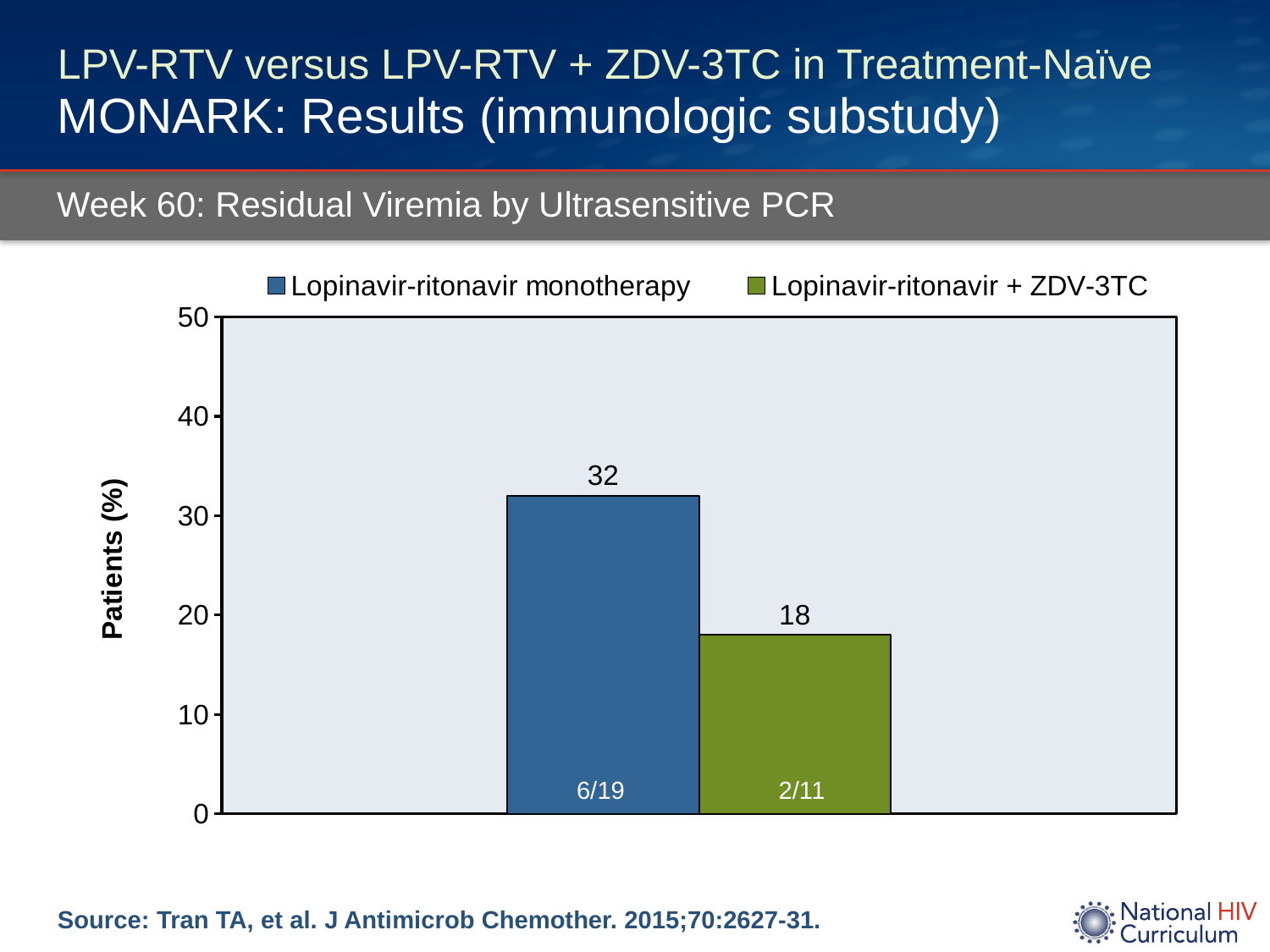
What fraction is printed inside the Lopinavir-ritonavir monotherapy bar? 6/19 What is the label of the y axis? Patients (%) Which series has the higher value? Lopinavir-ritonavir monotherapy Is the value for Lopinavir-ritonavir monotherapy larger or smaller than the value for Lopinavir-ritonavir + ZDV-3TC? larger What is the difference between the Lopinavir-ritonavir monotherapy value and the Lopinavir-ritonavir + ZDV-3TC value? 14 Which series has the lower value? Lopinavir-ritonavir + ZDV-3TC Is the value for Lopinavir-ritonavir monotherapy greater or less than 30? greater What is the value for Lopinavir-ritonavir + ZDV-3TC? 18 What kind of chart is shown? bar chart What is the value for Lopinavir-ritonavir monotherapy? 32 How many series does the legend list? 2 Is the value for Lopinavir-ritonavir + ZDV-3TC greater or less than 20? less